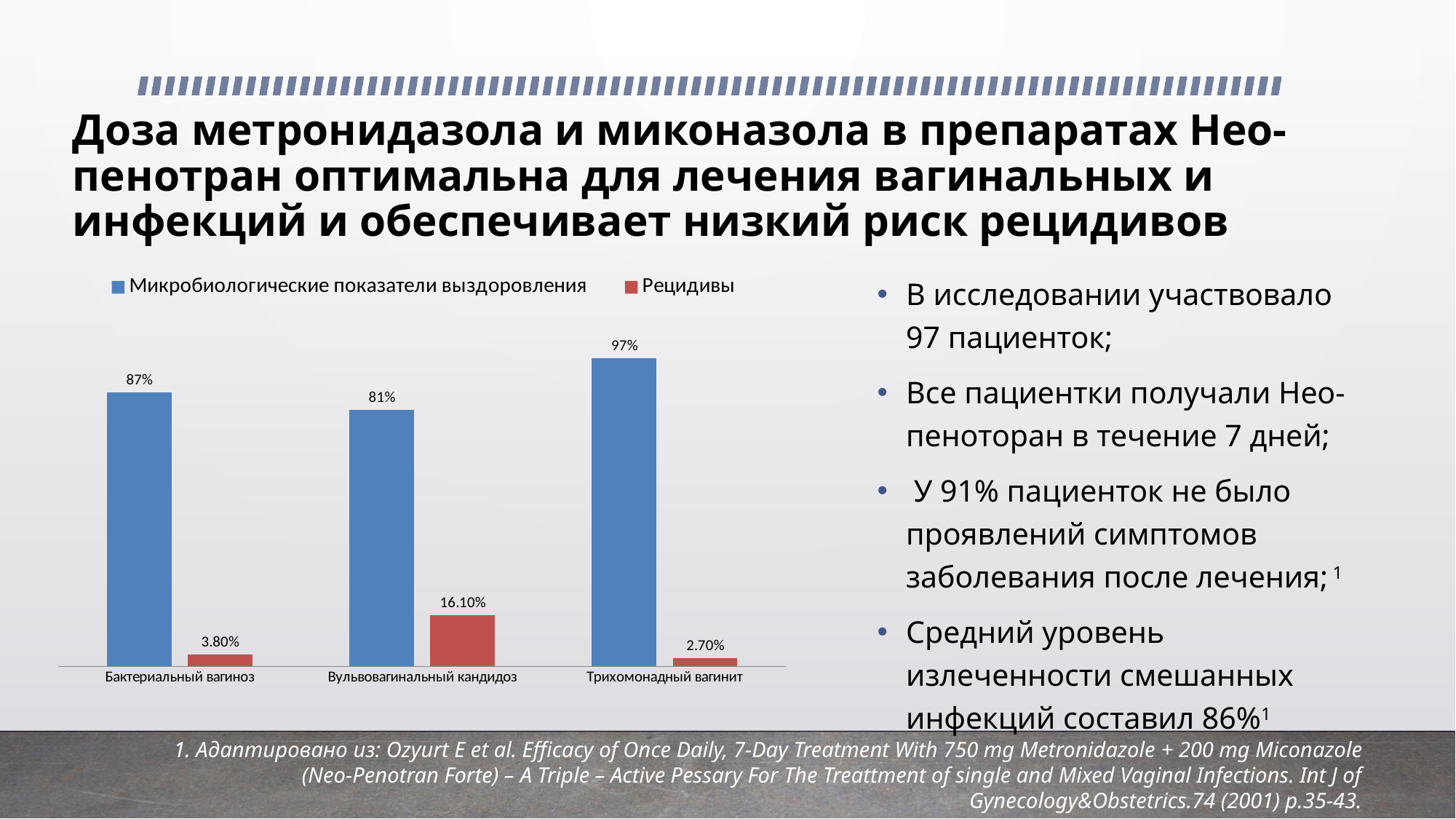
What is the value of Микробиологические показатели выздоровления for Бактериальный вагиноз? 87% What colour are the bars for the Рецидивы series? Red How many series does the legend list? 2 Which is larger: the Рецидивы value for Бактериальный вагиноз or for Вульвовагинальный кандидоз? Вульвовагинальный кандидоз What kind of chart is shown on the slide? Bar chart What is the value of Микробиологические показатели выздоровления for Трихомонадный вагинит? 97% How many categories are shown on the x axis? 3 What is the value of Рецидивы for Трихомонадный вагинит? 2.70% Which category has the highest value for Микробиологические показатели выздоровления? Трихомонадный вагинит What is the difference between the Микробиологические показатели выздоровления values for Трихомонадный вагинит and Вульвовагинальный кандидоз? 16% Which category has the lowest value for Рецидивы? Трихомонадный вагинит What is the value of Рецидивы for Вульвовагинальный кандидоз? 16.10%